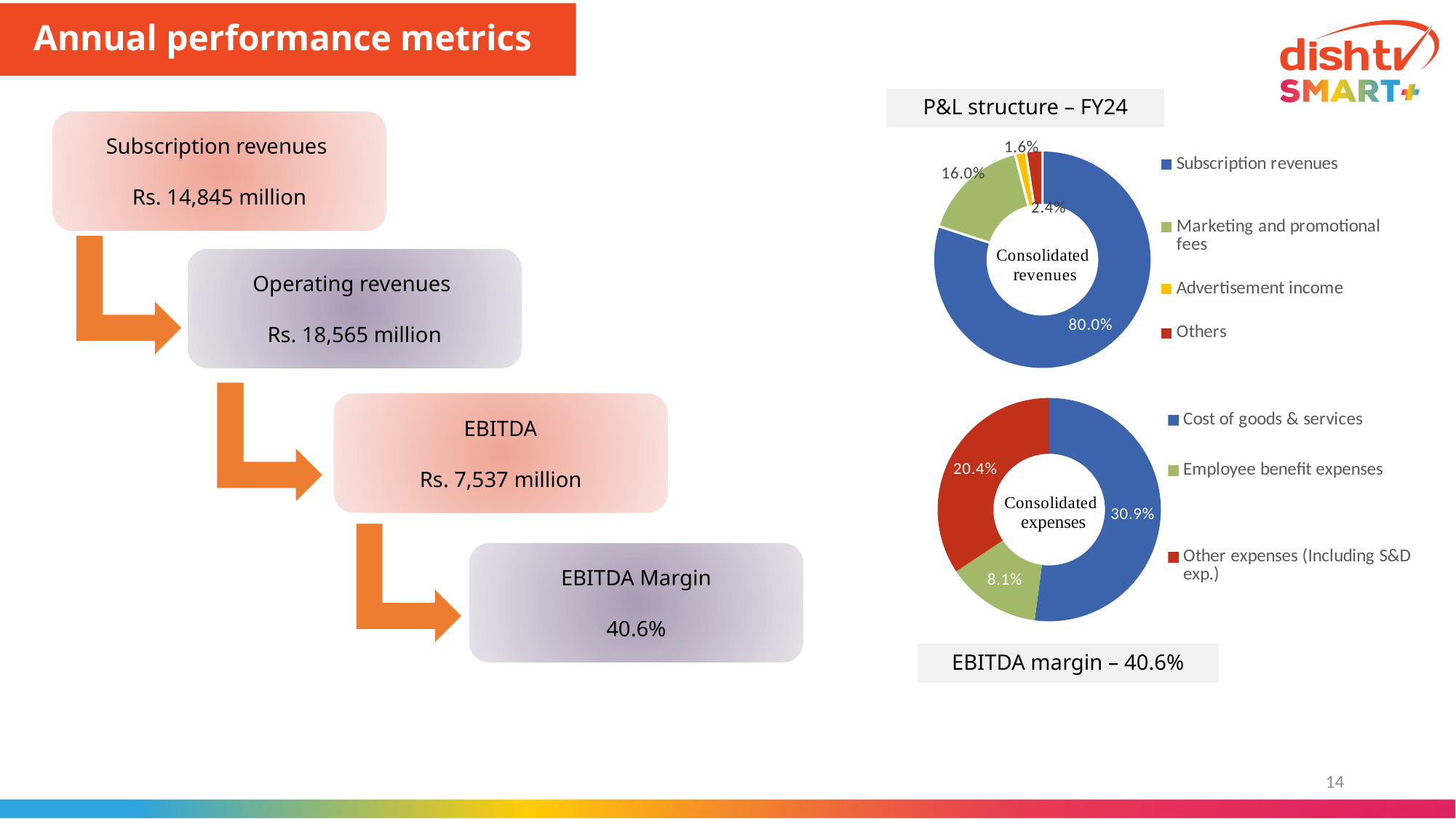
In the Consolidated revenues chart, what share is Marketing and promotional fees? 16.0% In the Consolidated expenses chart, which category has the smallest value? Employee benefit expenses In the Consolidated expenses chart, what is the difference between Cost of goods & services and Other expenses (Including S&D exp.)? 10.5% What kind of chart is the Consolidated revenues chart? Doughnut chart In the Consolidated revenues chart, what is the difference between the Subscription revenues share and the Marketing and promotional fees share? 64.0% In the Consolidated revenues chart, which category has the largest share? Subscription revenues How many categories does the legend of the Consolidated revenues chart list? 4 In the Consolidated expenses chart, what is the value for Cost of goods & services? 30.9% In the Consolidated expenses chart, what is the value for Other expenses (Including S&D exp.)? 20.4% In the Consolidated revenues chart, what share is Subscription revenues? 80.0% In the Consolidated expenses chart, which is larger: Cost of goods & services or Other expenses (Including S&D exp.)? Cost of goods & services In the Consolidated expenses chart, what is the value for Employee benefit expenses? 8.1%